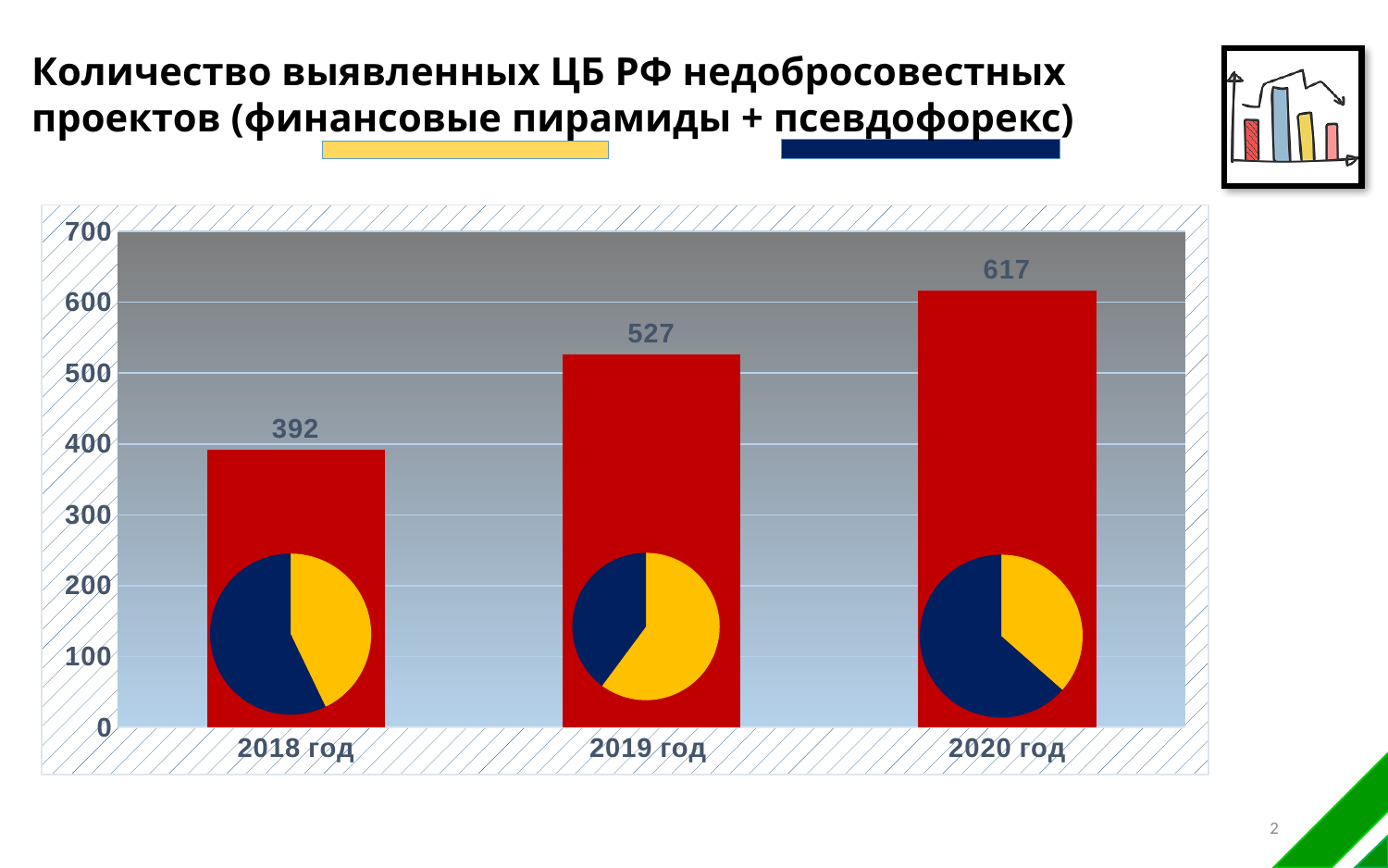
How many years are shown on the x axis? 3 What kind of chart is shown on the slide? bar chart Do the values rise or fall from 2018 год to 2020 год? rise What is the value for 2019 год? 527 Which year has the lowest value? 2018 год Which is larger, the value for 2019 год or the value for 2020 год? 2020 год What is the difference between the values for 2020 год and 2018 год? 225 What is the value for 2018 год? 392 What is the difference between the values for 2019 год and 2018 год? 135 Which year has the highest value? 2020 год Is the value for 2019 год greater or less than 500? greater What is the value for 2020 год? 617